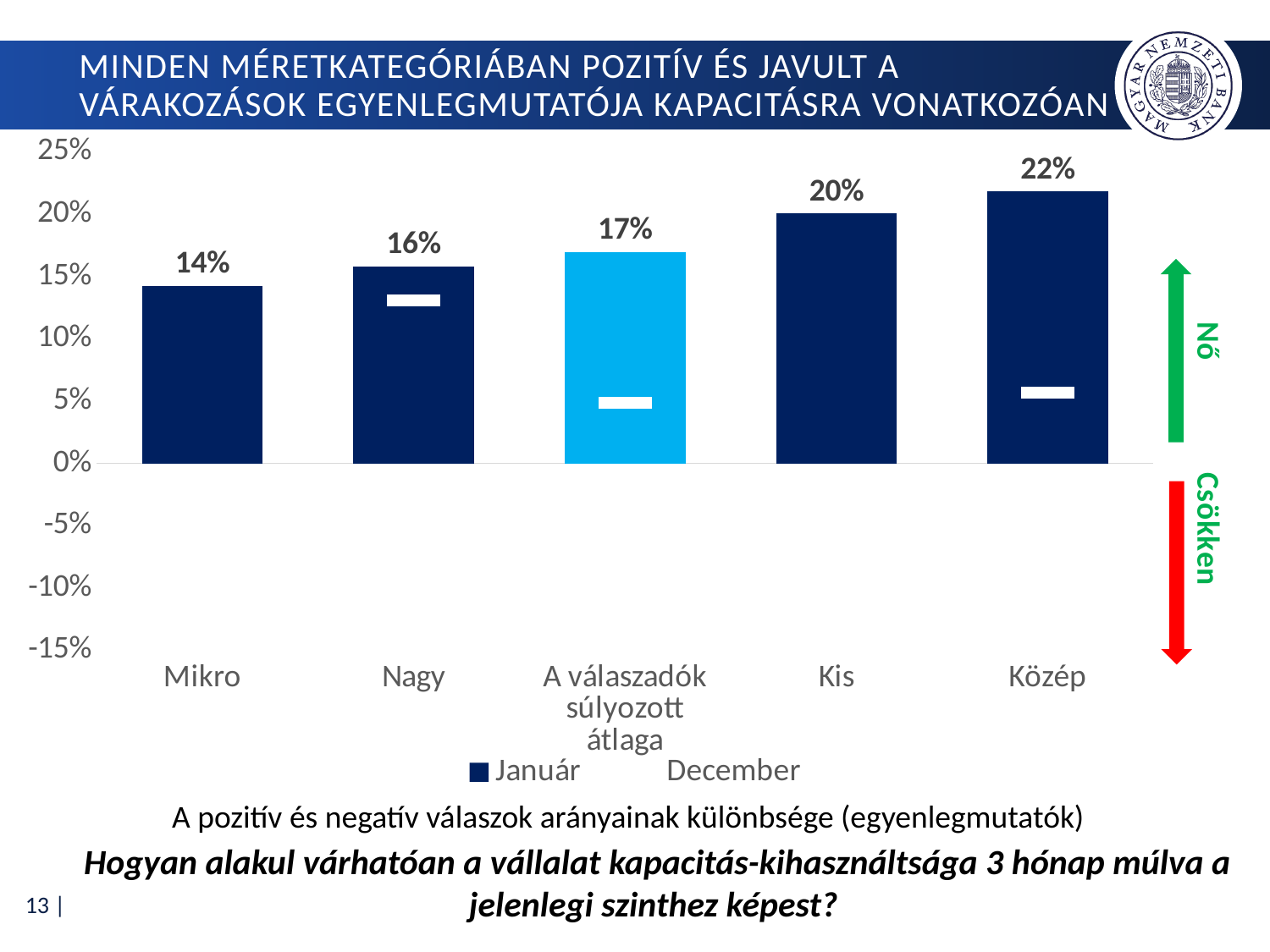
What is the Január value for 'A válaszadók súlyozott átlaga'? 17% Which has a larger Január value, Kis or Nagy? Kis Is the December value for Nagy greater or less than 10%? greater What kind of chart is shown on the slide? bar chart How many categories are shown on the x axis? 5 What is the Január value for Közép? 22% What is the Január value for Mikro? 14% How many series does the legend list? 2 Is the December value for 'A válaszadók súlyozott átlaga' greater or less than 10%? less What is the difference between the Január values for Közép and Mikro? 8% Which category has the highest Január value? Közép Which category has the lowest Január value? Mikro